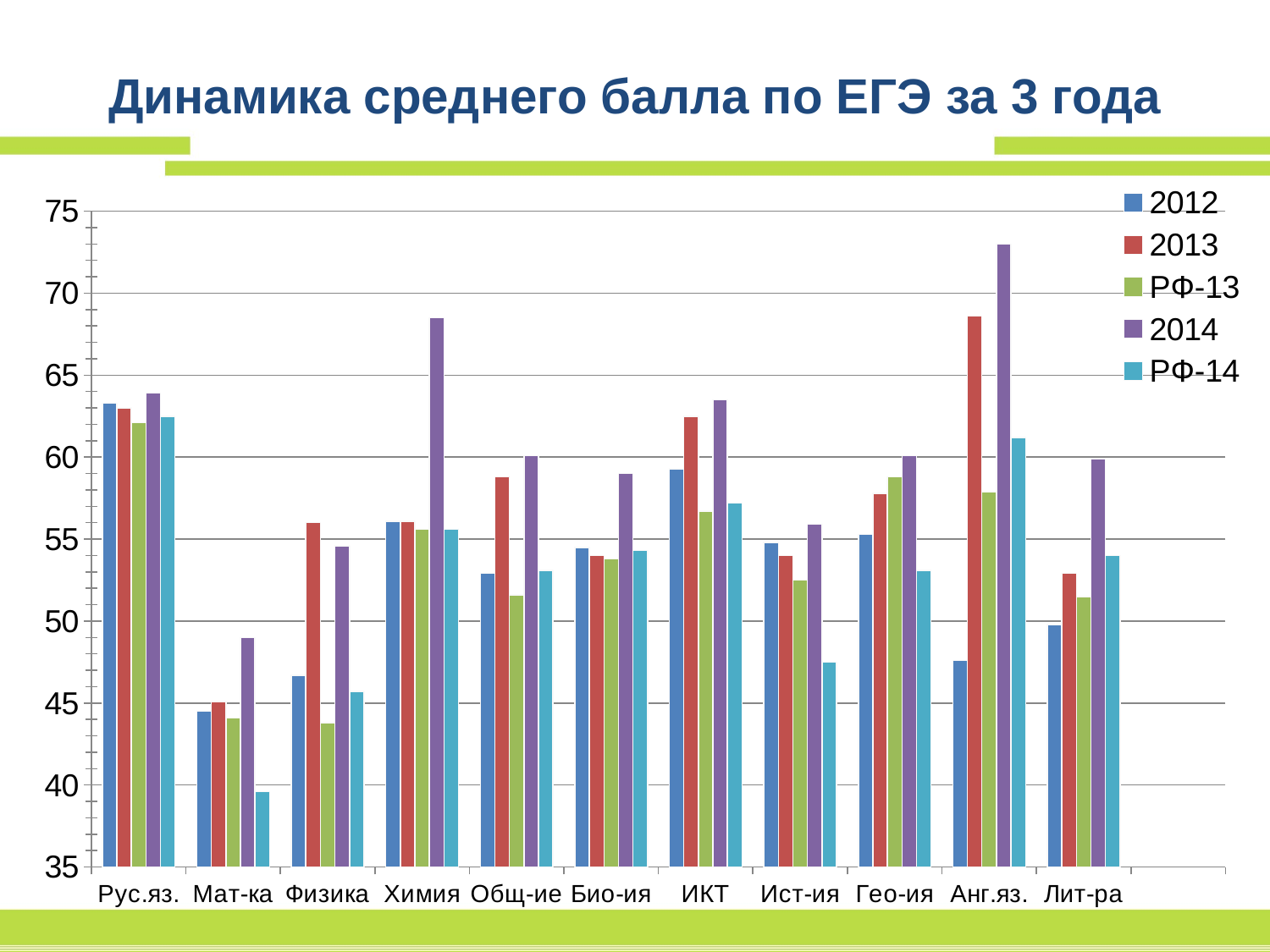
For which subject does the 2014 series reach its highest value? Анг.яз. Is the РФ-14 value for Мат-ка greater or less than 40? less Is the 2014 value for Химия greater or less than 65? greater Is the 2014 value for Анг.яз. greater or less than 70? greater What is the title of the chart? Динамика среднего балла по ЕГЭ за 3 года For which subject does the 2012 series have its lowest value? Мат-ка For Мат-ка, which is larger: the 2014 value or the РФ-14 value? 2014 How many series does the legend list? 5 How many subject categories are shown on the x axis? 11 What kind of chart is shown on the slide? bar chart For Химия, which is larger: the 2013 value or the 2014 value? 2014 Which series is shown in purple in the legend? 2014